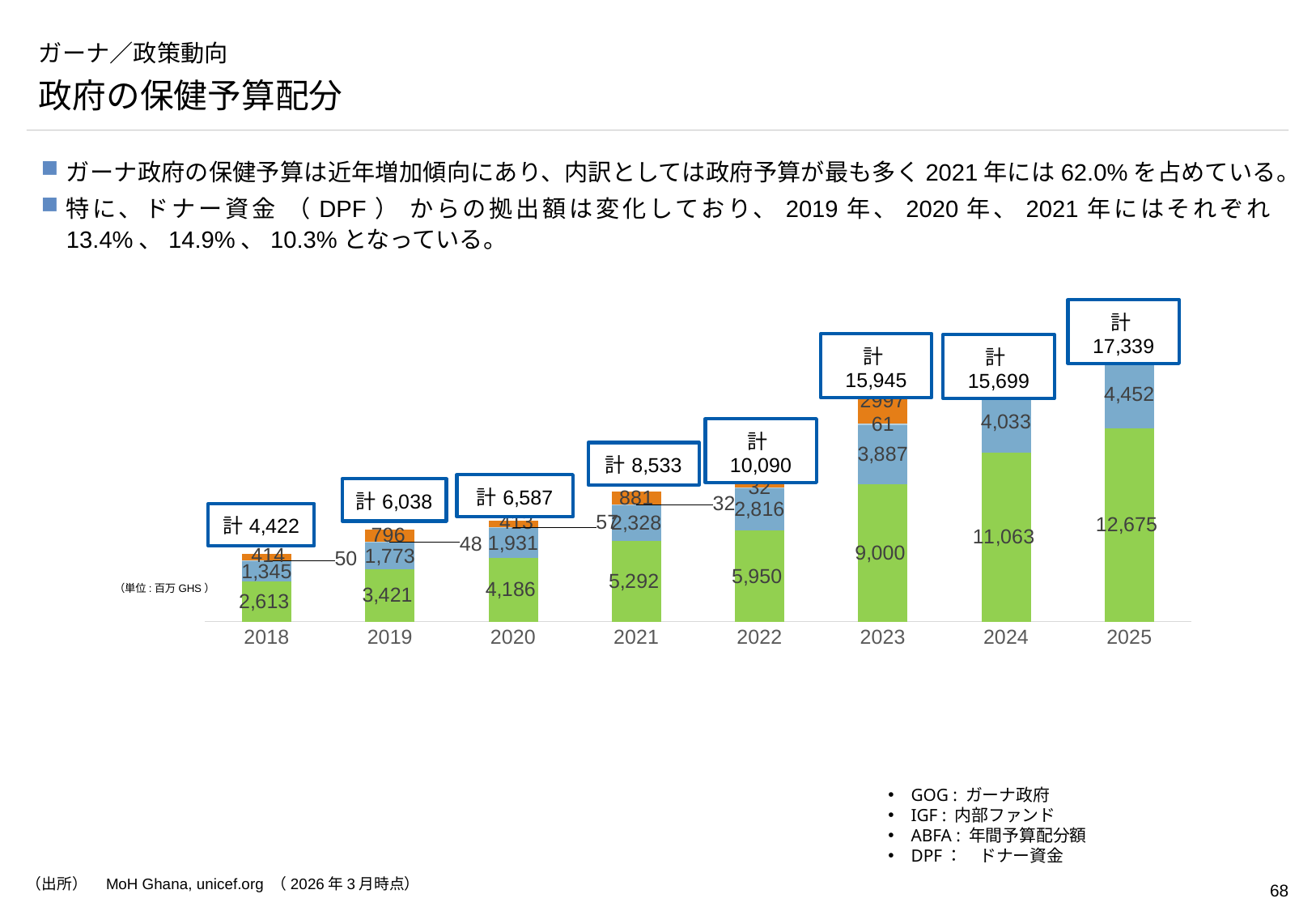
What is the value of the blue (middle) segment for 2024? 4,033 What is the value of the green (bottom) segment for 2025? 12,675 How many years are shown on the x axis of the chart? 8 What is the total (計) for 2018? 4,422 Which year has the lowest total (計)? 2018 Which year has the highest total (計)? 2025 What is the total (計) for 2025? 17,339 What is the value of the green (bottom) segment for 2023? 9,000 What kind of chart is shown on the slide? Stacked bar chart Which total is larger, 2023 or 2024? 2023 What unit is stated for the chart values? 百万 GHS What is the difference between the totals for 2025 and 2024? 1,640